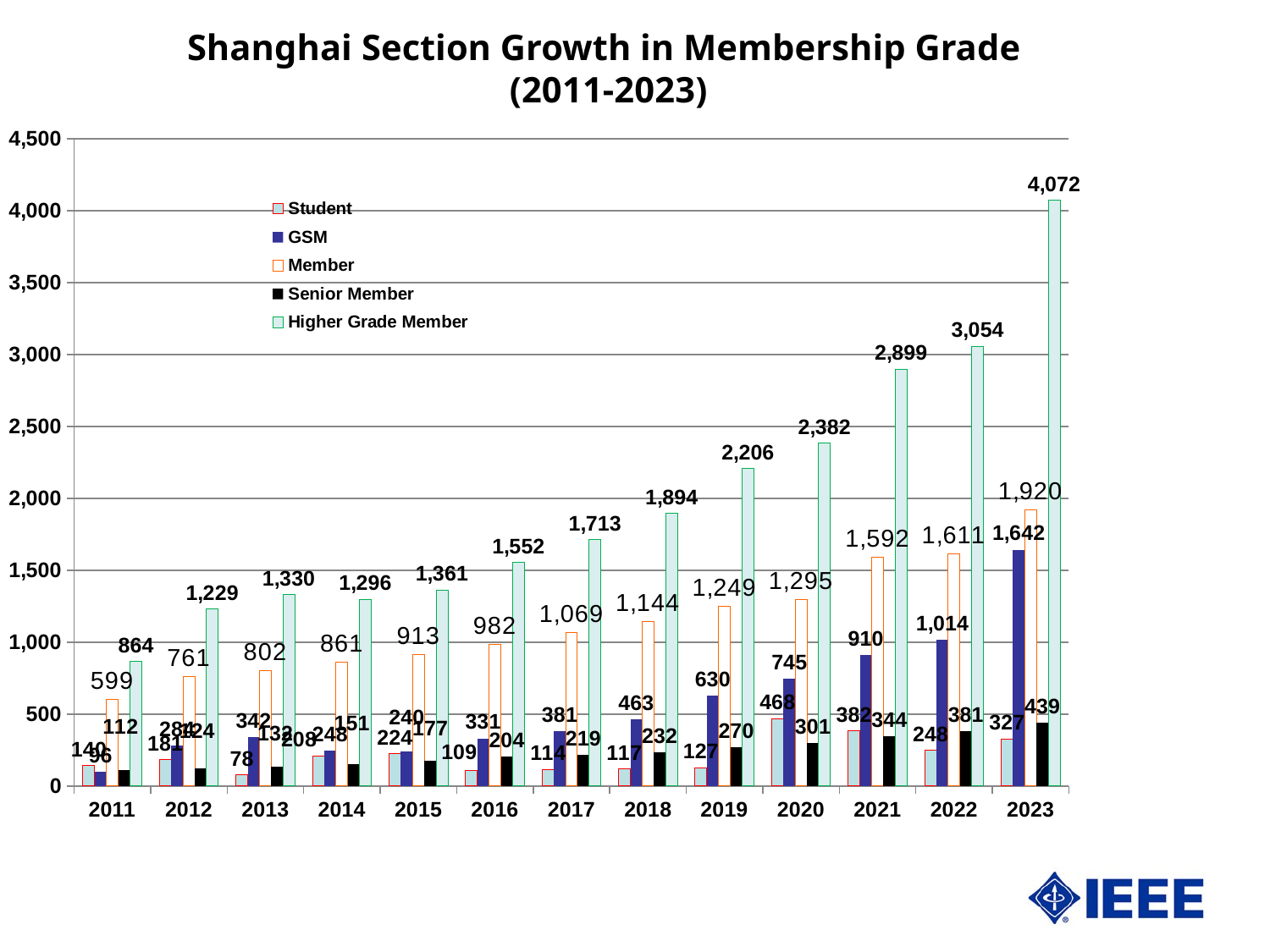
What is the value for GSM in 2022? 1,014 What is the value for Senior Member in 2023? 439 How many series does the legend list? 5 How many years are shown on the x axis? 13 What kind of chart is shown on the slide? bar chart In which year is the Higher Grade Member value lowest? 2011 What is the value for Higher Grade Member in 2023? 4,072 What is the value for Member in 2011? 599 What is the difference between the Higher Grade Member values in 2023 and 2022? 1,018 In 2023, which is larger: the GSM value or the Member value? Member In which year is the Higher Grade Member value highest? 2023 Is the Higher Grade Member value for 2019 greater or less than 2,000? greater